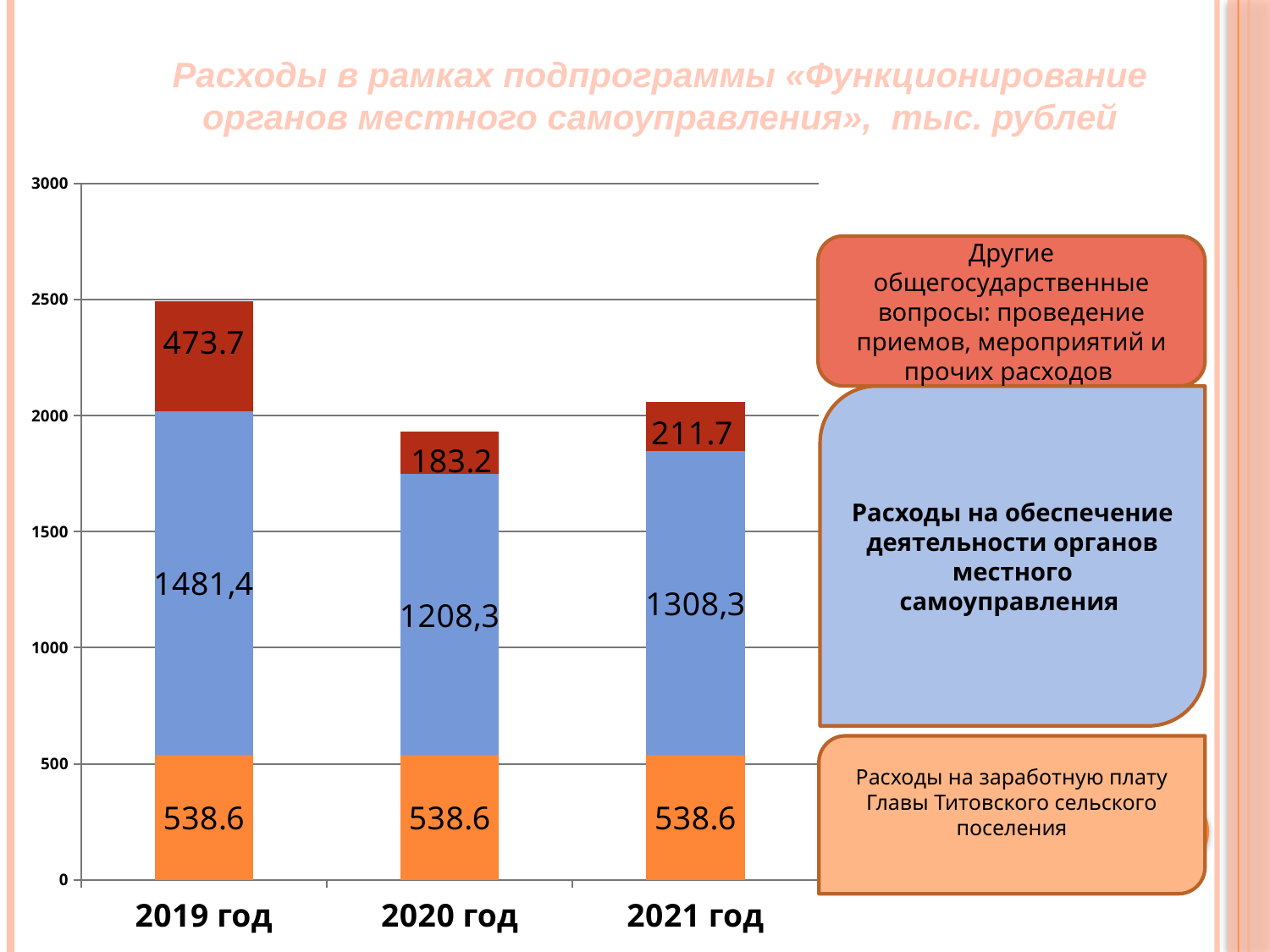
What is the value of the red segment (Другие общегосударственные вопросы) for 2020 год? 183.2 Which is larger: the blue segment for 2020 год or the blue segment for 2021 год? 2021 год What is the total of the stacked bar for 2020 год? 1930.1 What type of chart is shown on the slide? stacked bar chart How many series (segments per bar) does the chart show? 3 What is the difference between the red segment values for 2019 год and 2021 год? 262.0 How many years (categories) are shown on the x axis of the chart? 3 Is the total height of the 2019 год bar greater or less than 2000? greater What is the value of the orange segment (Расходы на заработную плату Главы Титовского сельского поселения) for 2021 год? 538.6 In which year is the red segment (Другие общегосударственные вопросы) the largest? 2019 год What is the value of the blue segment (Расходы на обеспечение деятельности органов местного самоуправления) for 2019 год? 1481,4 In which year is the blue segment (Расходы на обеспечение деятельности органов местного самоуправления) the smallest? 2020 год